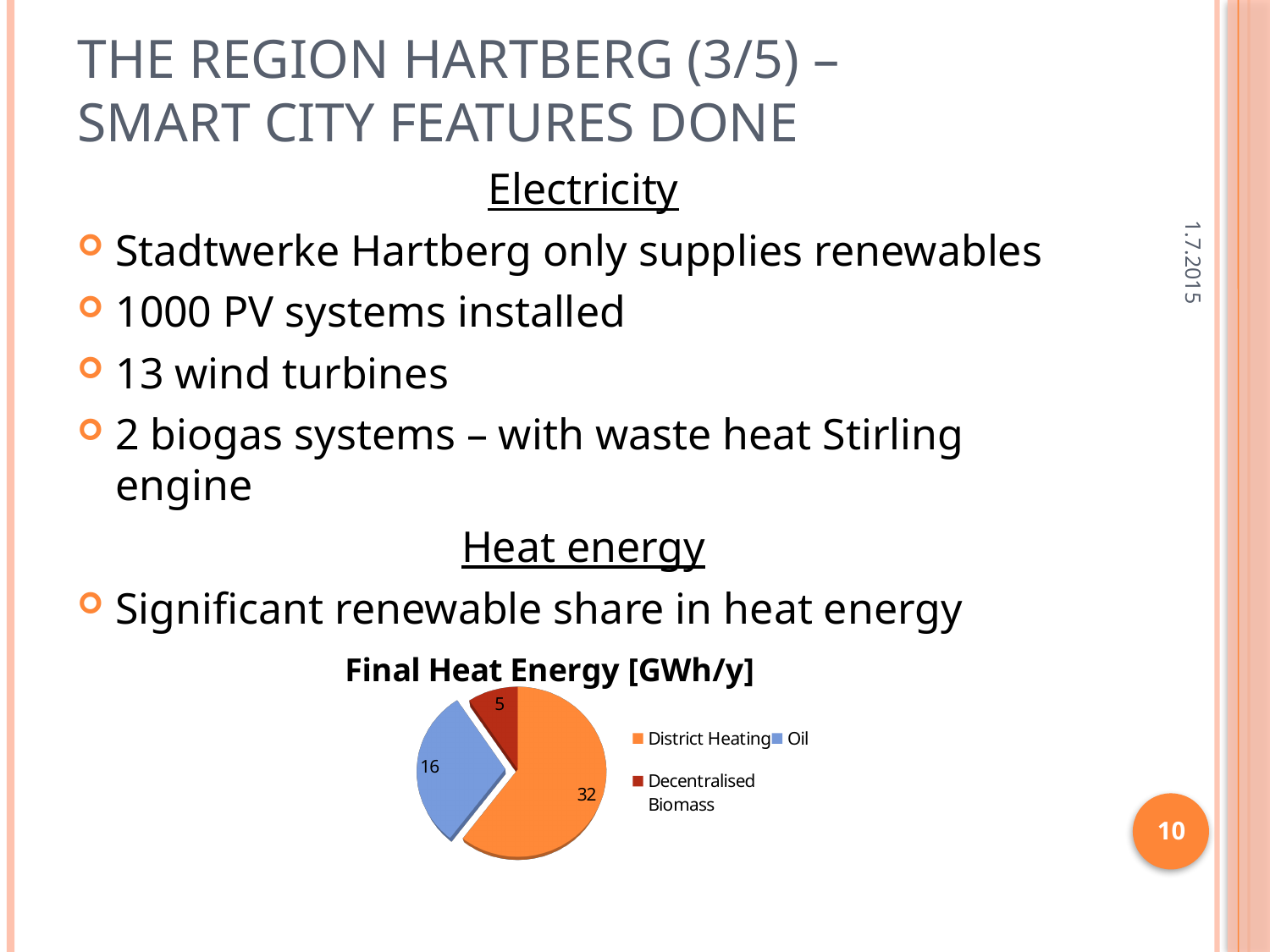
What type of chart is shown on the slide? pie chart What is the difference between the Oil and Decentralised Biomass values in the Final Heat Energy pie chart? 11 What is the total of all slices in the Final Heat Energy pie chart? 53 What is the value for Decentralised Biomass in the Final Heat Energy pie chart? 5 How many categories are shown in the Final Heat Energy pie chart? 3 What is the title of the chart? Final Heat Energy [GWh/y] Which category has the largest slice in the Final Heat Energy pie chart? District Heating Which is larger in the Final Heat Energy pie chart, Oil or Decentralised Biomass? Oil Which category has the smallest slice in the Final Heat Energy pie chart? Decentralised Biomass What is the value for Oil in the Final Heat Energy pie chart? 16 What is the difference between the District Heating and Oil values in the Final Heat Energy pie chart? 16 What is the value for District Heating in the Final Heat Energy pie chart? 32